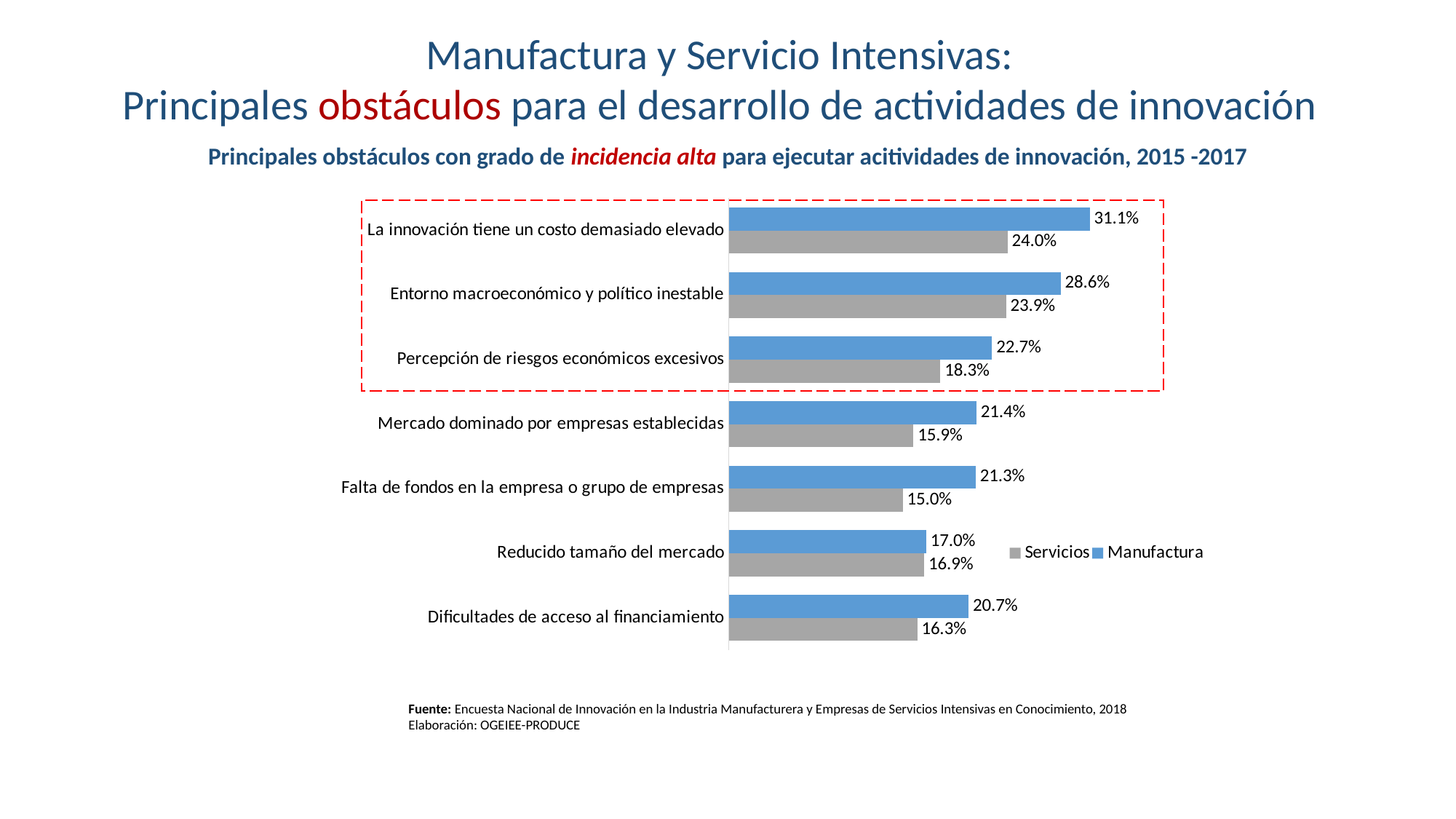
How many categories are enclosed by the red dashed box? 3 Which category has the lowest Servicios value? Falta de fondos en la empresa o grupo de empresas Which category has the highest Manufactura value? La innovación tiene un costo demasiado elevado What is the Servicios value for "Falta de fondos en la empresa o grupo de empresas"? 15.0% What is the difference between the Manufactura and Servicios values for "Entorno macroeconómico y político inestable"? 4.7% What is the Servicios value for "Percepción de riesgos económicos excesivos"? 18.3% How many series does the legend list? 2 What is the Manufactura value for "La innovación tiene un costo demasiado elevado"? 31.1% Which is larger for "Dificultades de acceso al financiamiento": the Manufactura value or the Servicios value? Manufactura What kind of chart is shown on the slide? Bar chart Which colour represents the Servicios series? Grey How many obstacle categories are shown in the chart? 7